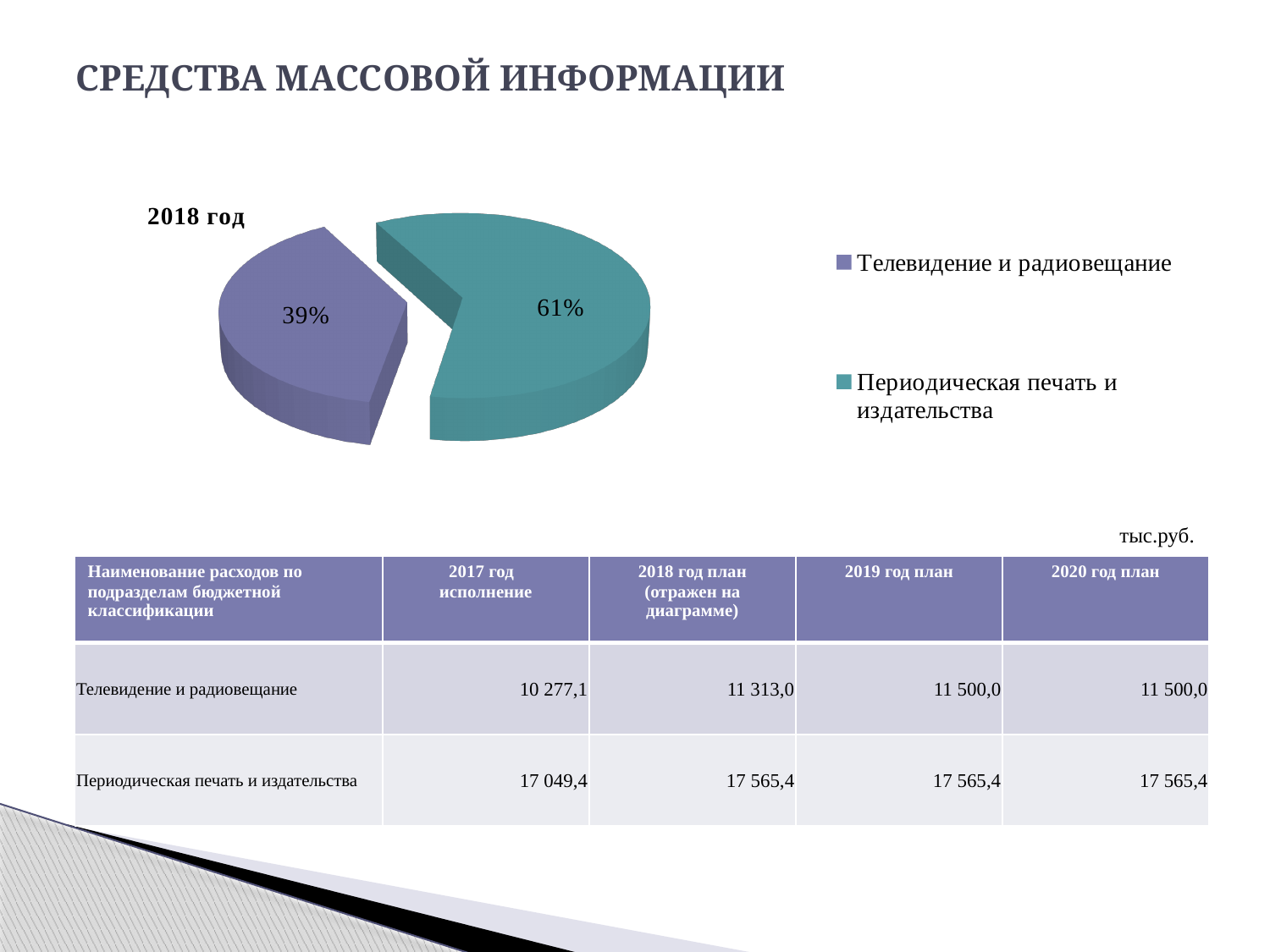
How many slices does the pie chart have? 2 What share of the pie does "Телевидение и радиовещание" have? 39% What is the difference in percentage points between the two slices of the pie chart? 22 Which category has the smallest slice in the pie chart? Телевидение и радиовещание What share of the pie does "Периодическая печать и издательства" have? 61% Which category has the largest slice in the pie chart? Периодическая печать и издательства What kind of chart is shown on the slide? Pie chart Which is larger in the pie chart: the share for "Телевидение и радиовещание" or the share for "Периодическая печать и издательства"? Периодическая печать и издательства What is the title of the pie chart? 2018 год Which colour represents "Телевидение и радиовещание" in the pie chart? Purple How many entries does the legend of the pie chart list? 2 Is the share for "Телевидение и радиовещание" greater or less than 50%? less